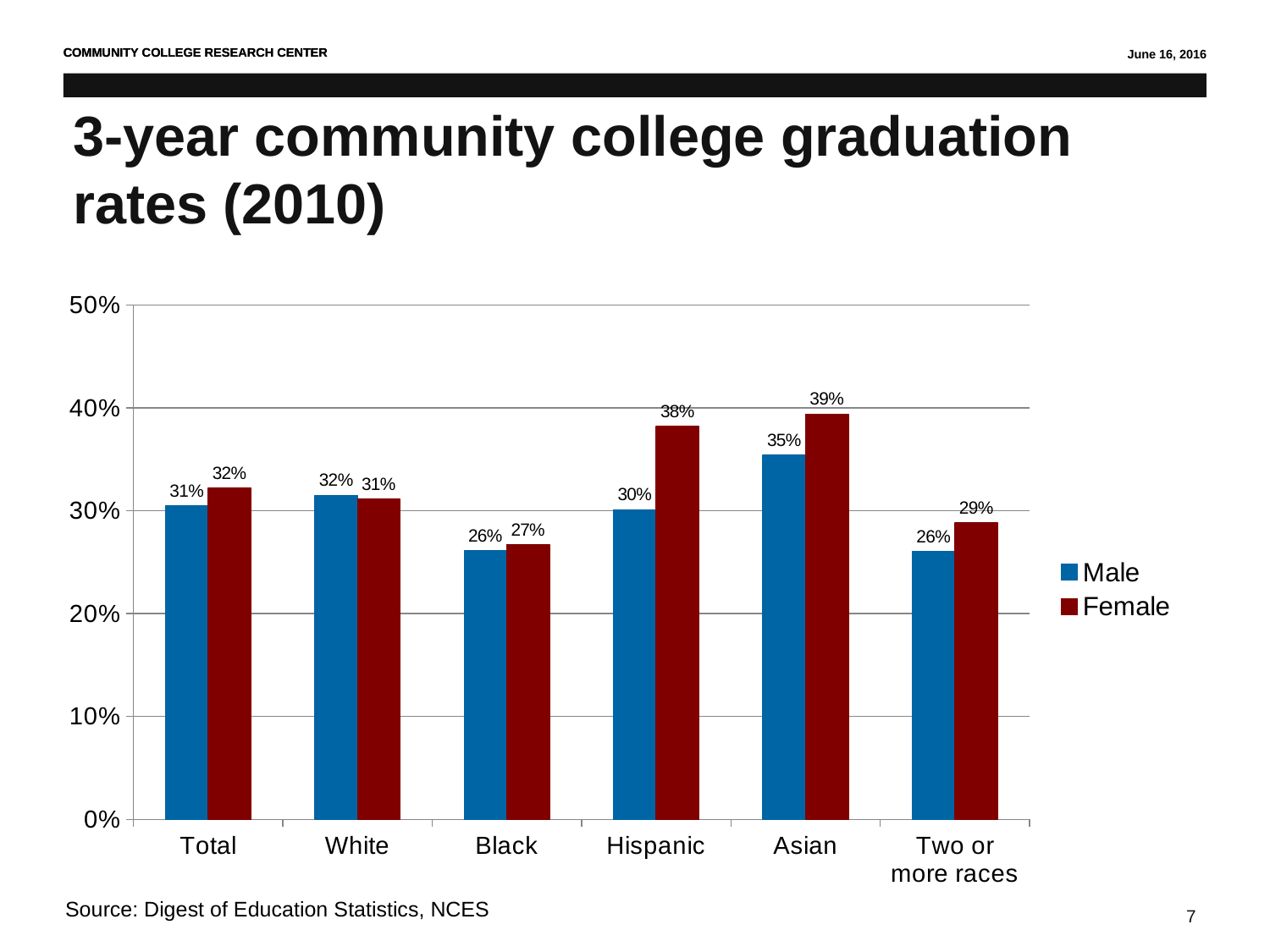
Which category has the lowest Female graduation rate? Black Which is larger for White students, the Male or the Female graduation rate? Male Which category has the highest Female graduation rate? Asian How many categories are shown on the x axis? 6 Is the Female graduation rate for Asian students greater or less than 30%? greater Which colour represents the Female series in the legend? Dark red What is the Male graduation rate for the Total category? 31% What is the Female graduation rate for Hispanic students? 38% What is the difference between the Female and Male graduation rates for Hispanic students? 8% What is the Male graduation rate for Asian students? 35% How many series does the legend list? 2 What kind of chart is shown on the slide? Bar chart